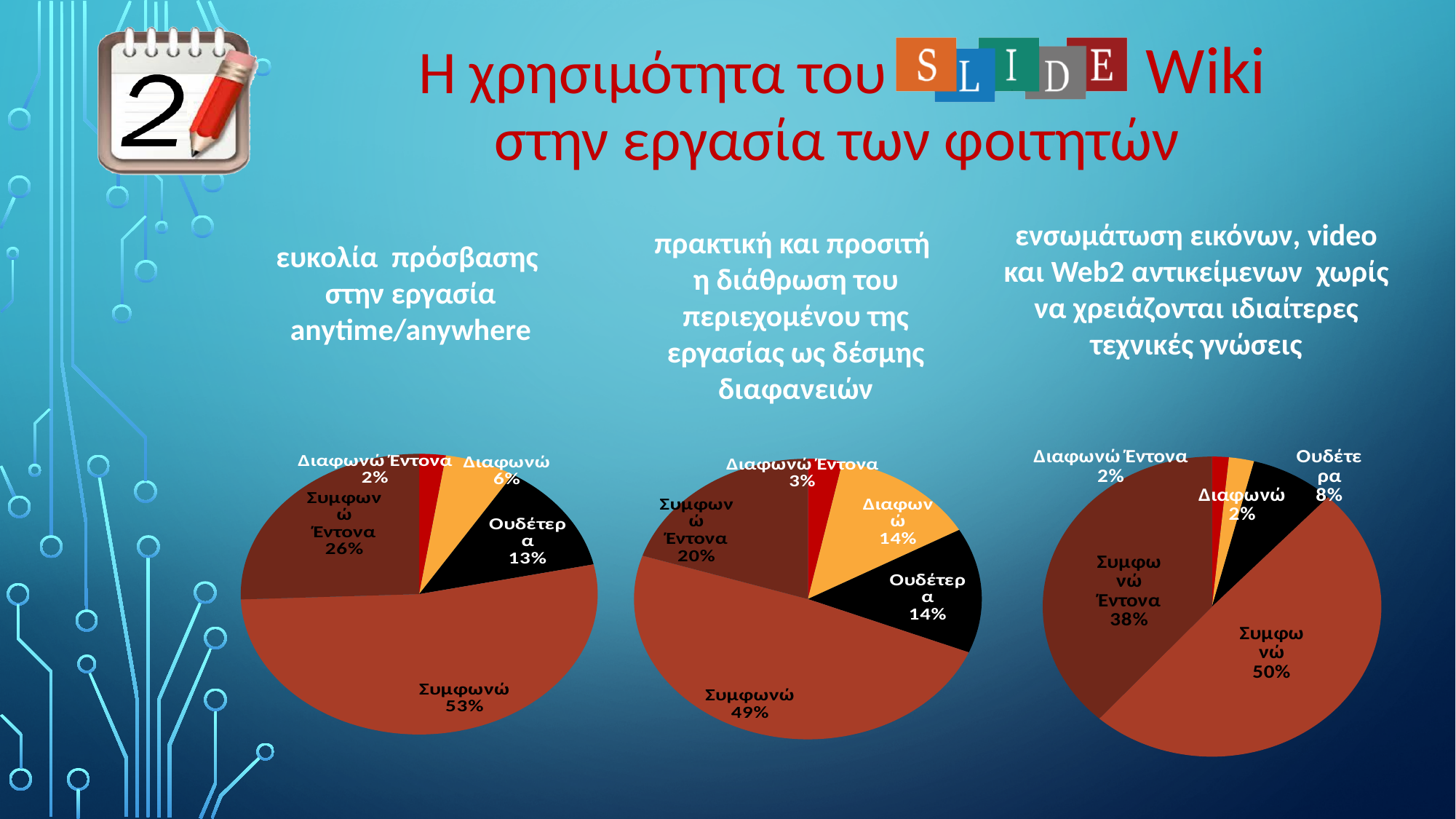
In the middle pie chart (πρακτική και προσιτή η διάθρωση του περιεχομένου), what share is labelled Συμφωνώ Έντονα? 20% In the left pie chart (ευκολία πρόσβασης στην εργασία anytime/anywhere), what share is labelled Ουδέτερα? 13% How many slices does the middle pie chart (πρακτική και προσιτή η διάθρωση του περιεχομένου) have? 5 In the left pie chart (ευκολία πρόσβασης στην εργασία anytime/anywhere), what share is labelled Συμφωνώ? 53% In the right pie chart (ενσωμάτωση εικόνων, video και Web2 αντικείμενων), what is the difference between the Συμφωνώ and Συμφωνώ Έντονα shares? 12% In the left pie chart (ευκολία πρόσβασης στην εργασία anytime/anywhere), which is larger: Συμφωνώ Έντονα or Ουδέτερα? Συμφωνώ Έντονα In the left pie chart (ευκολία πρόσβασης στην εργασία anytime/anywhere), which category has the smallest slice? Διαφωνώ Έντονα In the middle pie chart (πρακτική και προσιτή η διάθρωση του περιεχομένου), which category has the largest slice? Συμφωνώ What type of chart is used for the three charts on the slide? Pie chart In the right pie chart (ενσωμάτωση εικόνων, video και Web2 αντικείμενων), what share is labelled Συμφωνώ Έντονα? 38% In the middle pie chart (πρακτική και προσιτή η διάθρωση του περιεχομένου), what share is labelled Διαφωνώ Έντονα? 3% In the right pie chart (ενσωμάτωση εικόνων, video και Web2 αντικείμενων), what share is labelled Ουδέτερα? 8%